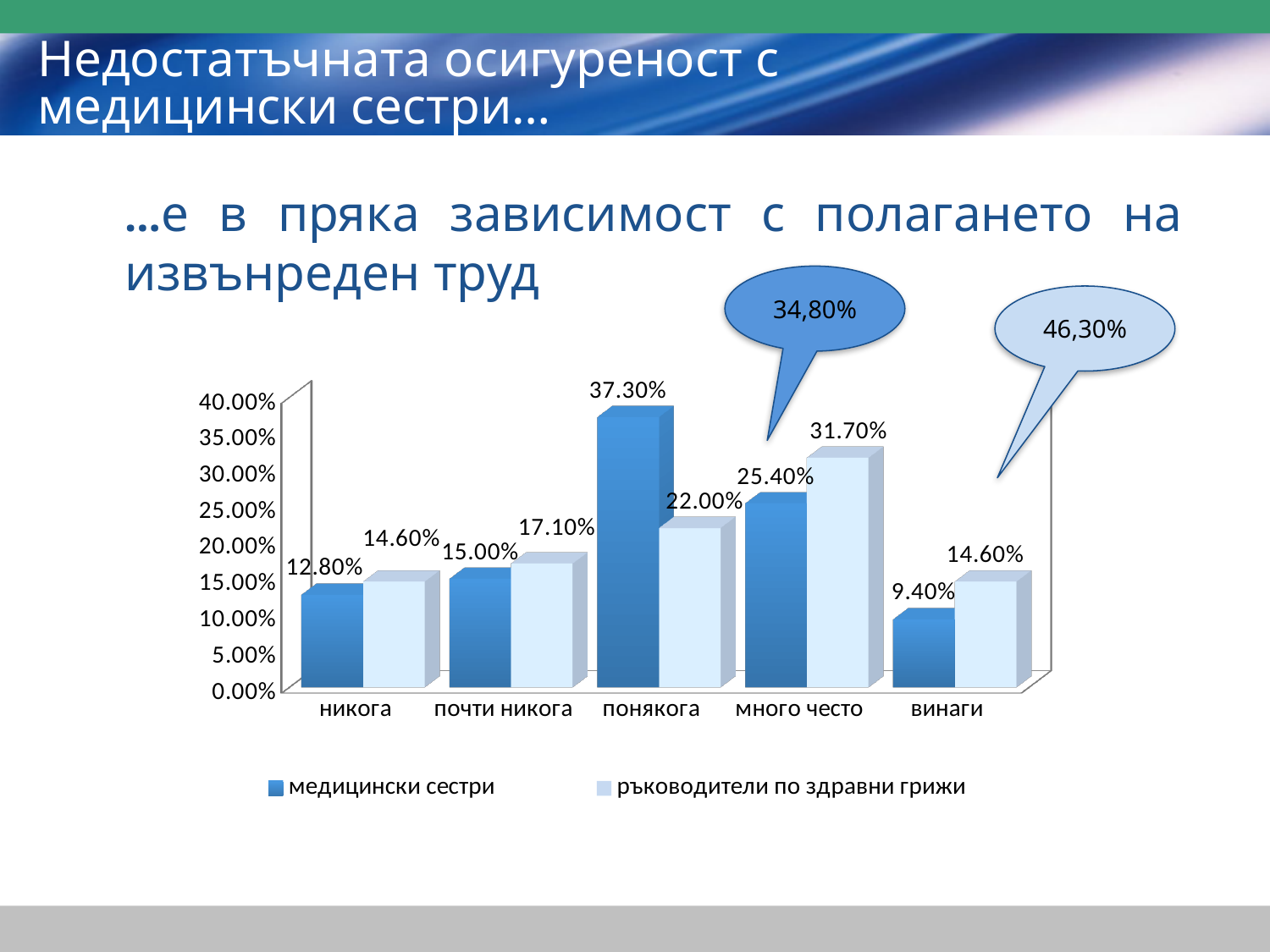
Which category has the highest value for медицински сестри? понякога What is the value for медицински сестри in the понякога category? 37.30% In the много често category, which series has the larger value: медицински сестри or ръководители по здравни грижи? ръководители по здравни грижи How many series does the legend list? 2 What is the difference between медицински сестри and ръководители по здравни грижи in the понякога category? 15.30% What is the value for ръководители по здравни грижи in the почти никога category? 17.10% Which category has the lowest value for медицински сестри? винаги What is the value for медицински сестри in the винаги category? 9.40% How many categories are shown on the x axis? 5 Which category has the highest value for ръководители по здравни грижи? много често What is the value for ръководители по здравни грижи in the много често category? 31.70% What kind of chart is shown on the slide? bar chart